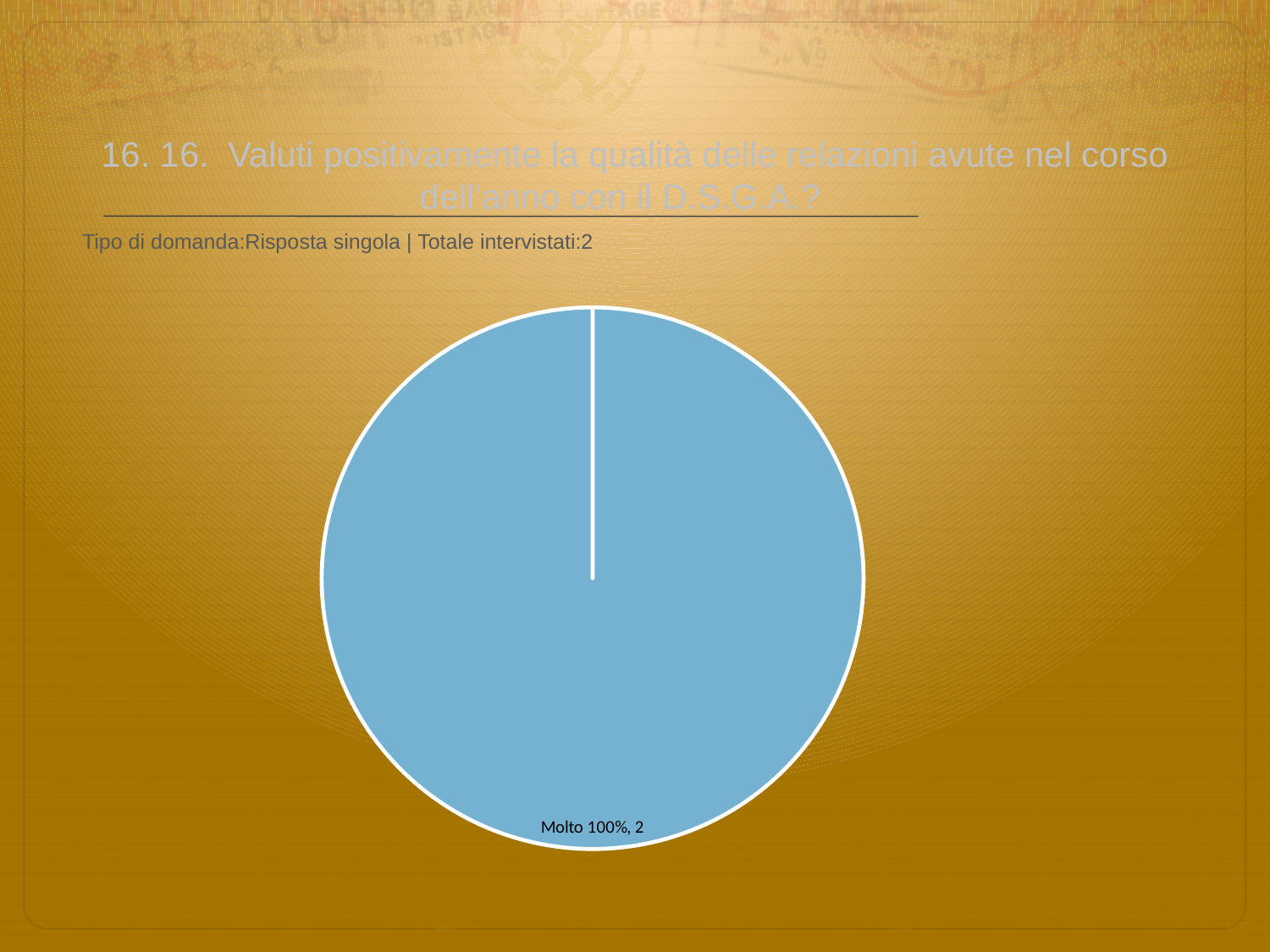
What share of the pie does the "Molto" slice represent? 100% What type of question (Tipo di domanda) is stated on the slide? Risposta singola What colour is the "Molto" slice of the pie chart? blue Which category is the largest slice of the pie chart? Molto How many slices does the pie chart have? 1 What kind of chart is shown on the slide? pie chart How many respondents are counted in the "Molto" slice? 2 What is the total number of respondents (Totale intervistati) shown on the slide? 2